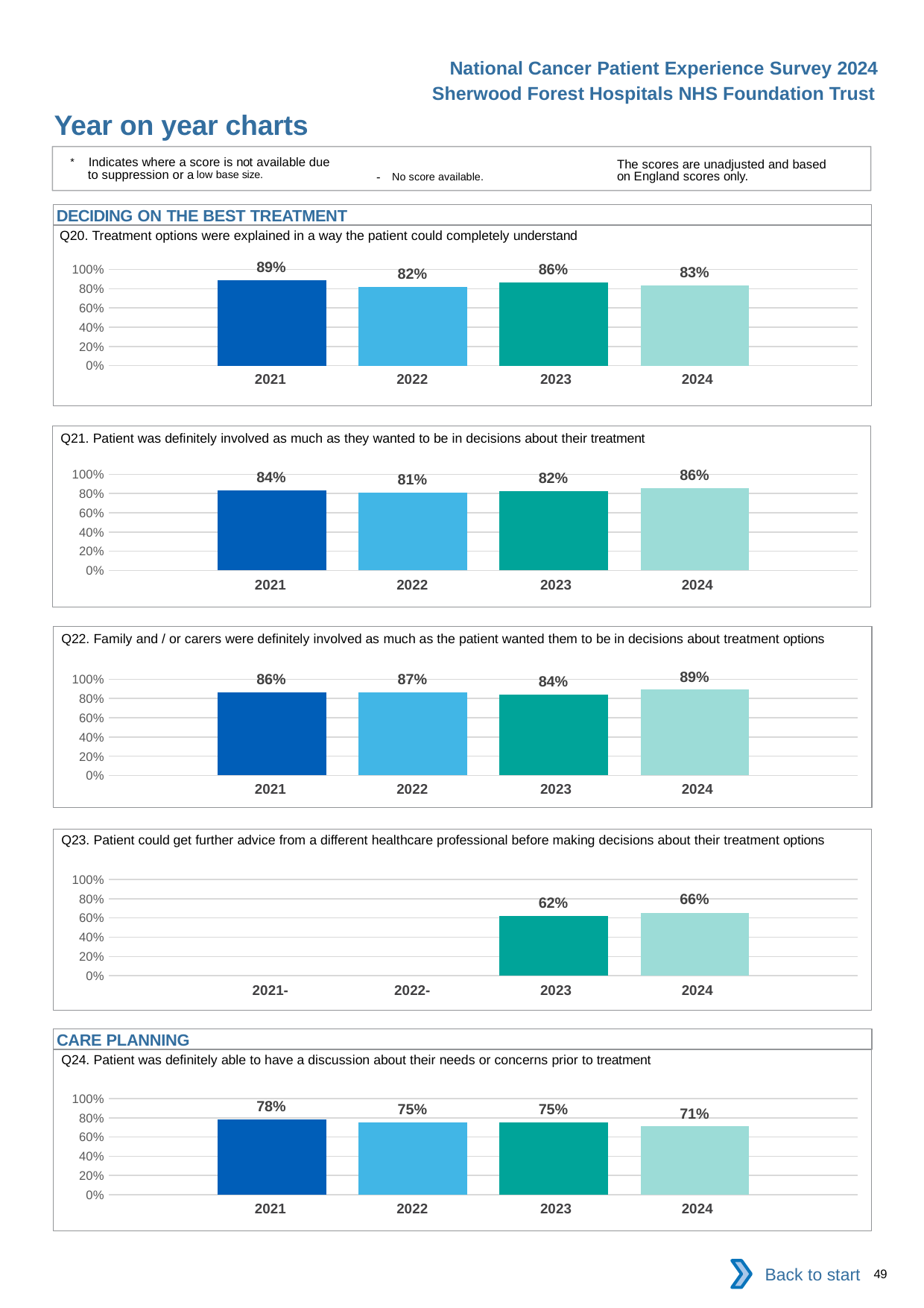
In the Q24 chart, do the values generally rise or fall from 2021 to 2024? fall In the Q21 chart (Patient was definitely involved as much as they wanted to be in decisions about their treatment), what is the value for 2024? 86% In the Q22 chart, what is the value for 2023? 84% In the Q23 chart (Patient could get further advice from a different healthcare professional), how many years have a bar plotted? 2 In the Q23 chart, what is the value for 2023? 62% In the Q23 chart, is the value for 2024 greater or less than 60%? greater In the Q20 chart (Treatment options were explained in a way the patient could completely understand), what is the value for 2021? 89% In the Q21 chart, what is the difference between the 2024 value and the 2022 value? 5% In the Q22 chart (Family and / or carers were definitely involved as much as the patient wanted them to be), which year has the highest value? 2024 What kind of chart is used for Q20? bar chart In the Q24 chart (Patient was definitely able to have a discussion about their needs or concerns prior to treatment), what is the value for 2024? 71% In the Q20 chart, which year has the lowest value? 2022